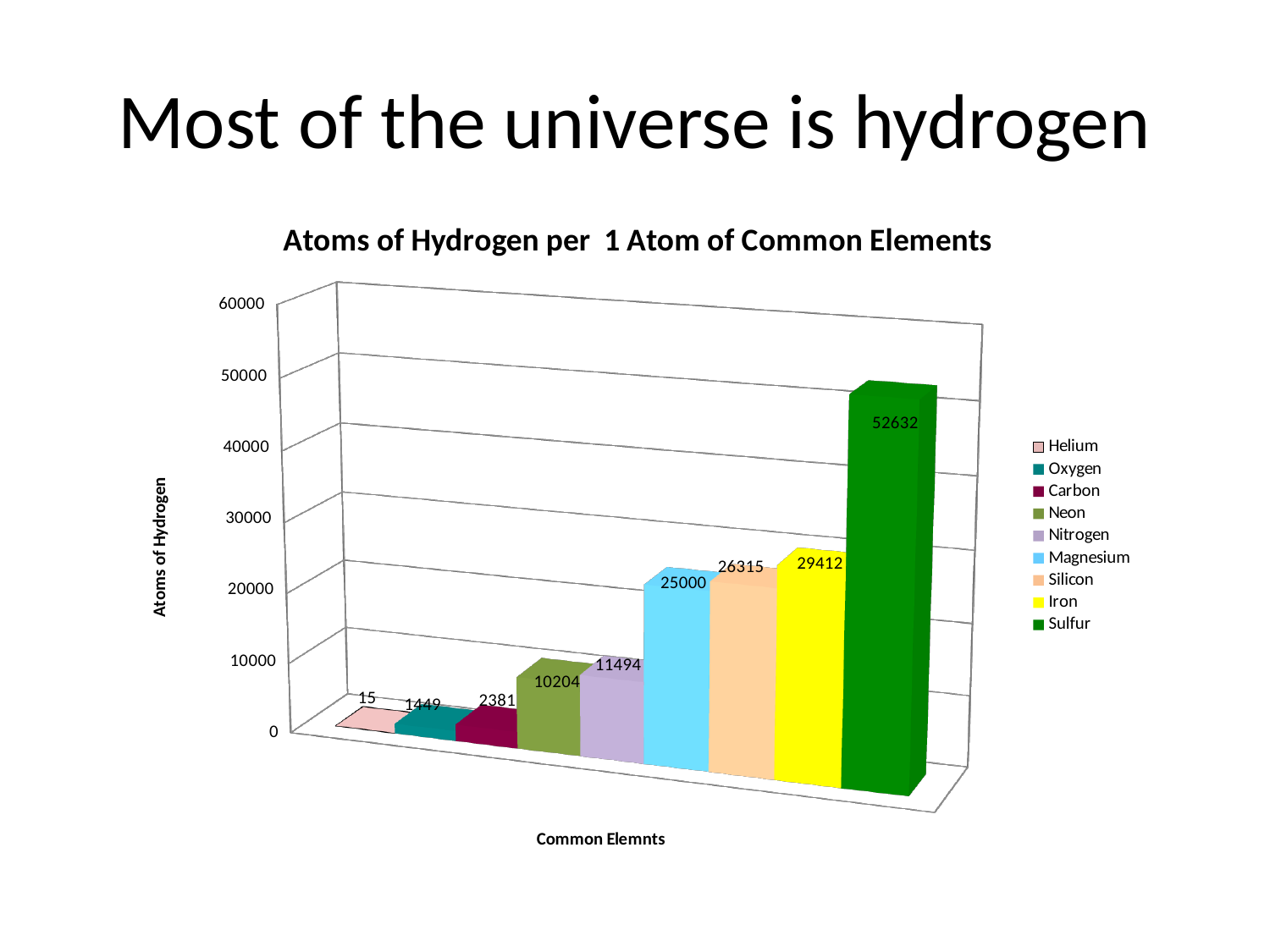
How many entries does the legend list? 9 Which is larger, the value for Nitrogen or the value for Neon? Nitrogen How many bars are plotted in the chart? 9 What is the value for Sulfur? 52632 Which element has the highest value? Sulfur What is the title of the chart? Atoms of Hydrogen per 1 Atom of Common Elements What is the value for Magnesium? 25000 What is the difference between the values for Iron and Silicon? 3097 What kind of chart is shown? Bar chart Which element has the lowest value? Helium What is the value for Neon? 10204 What is the value for Helium? 15